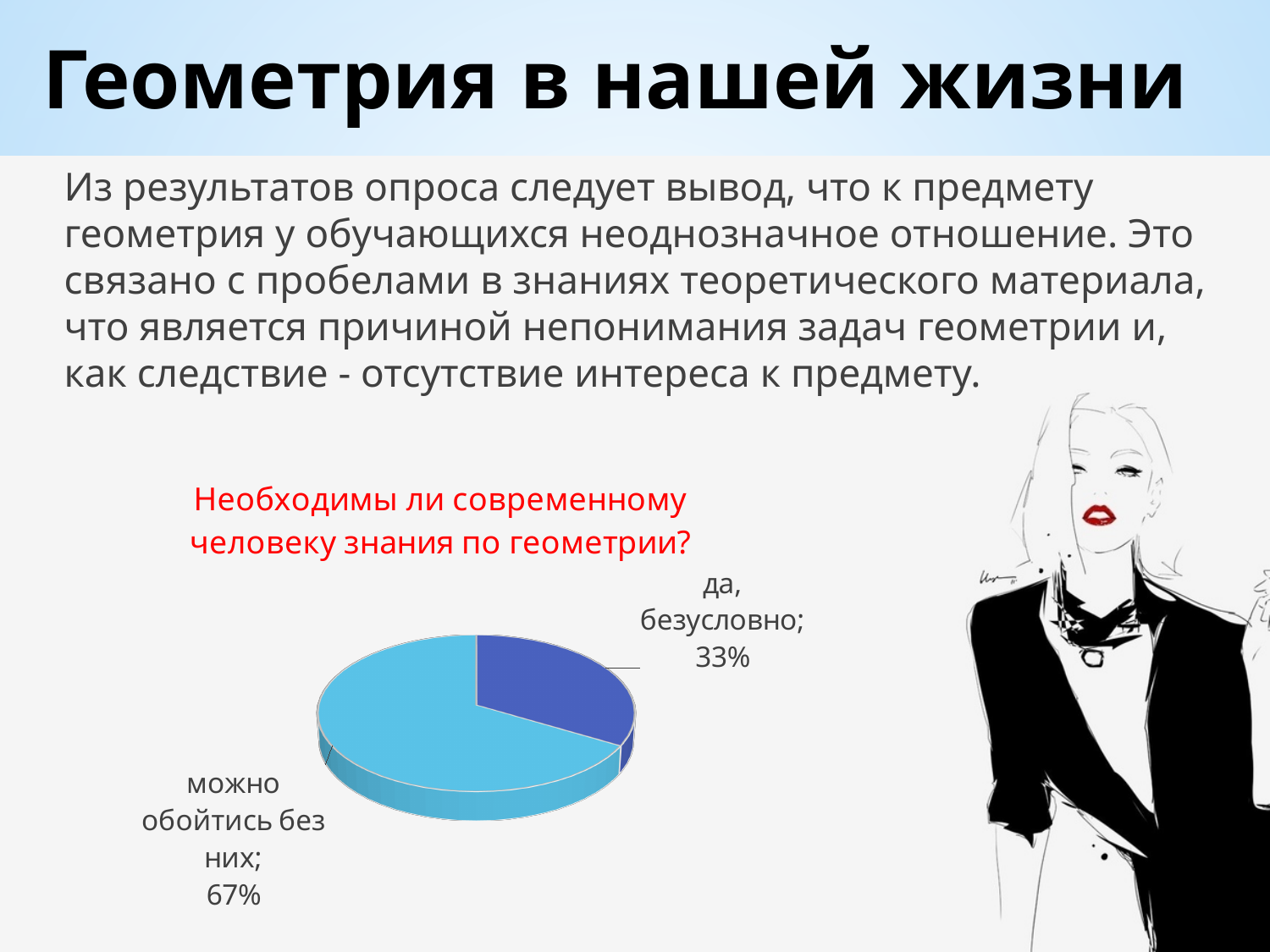
What share of the pie does the slice "можно обойтись без них" have? 67% What is the title of the pie chart? Необходимы ли современному человеку знания по геометрии? What kind of chart is shown on the slide? pie chart Which slice of the pie chart is the smallest? да, безусловно How many slices does the pie chart have? 2 Which is larger: the share for "да, безусловно" or the share for "можно обойтись без них"? можно обойтись без них What colour is the "да, безусловно" slice of the pie chart? dark blue What share of the pie does the slice "да, безусловно" have? 33% What is the difference in percentage points between the "можно обойтись без них" slice and the "да, безусловно" slice? 34 Which slice of the pie chart is the largest? можно обойтись без них